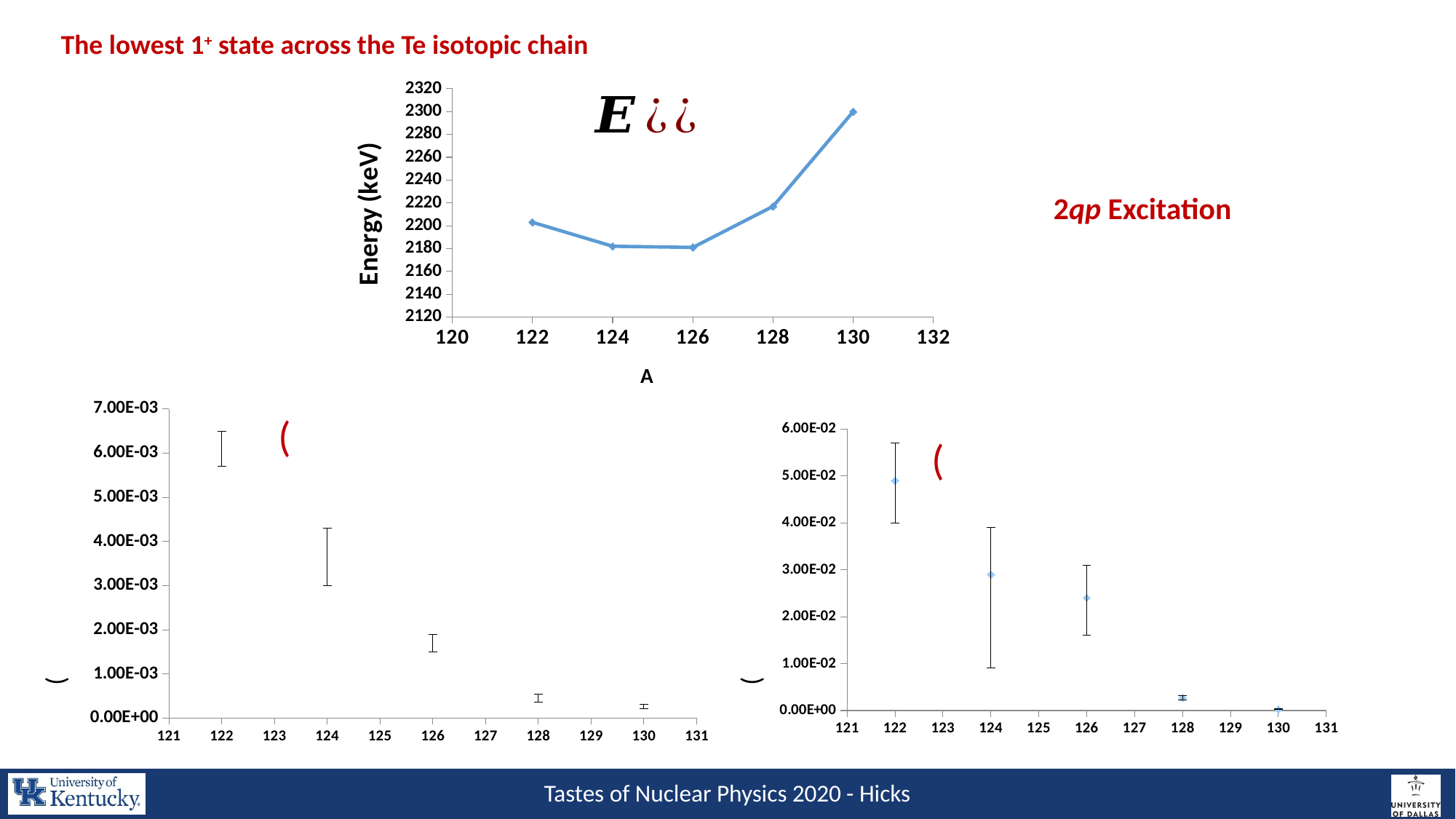
In the bottom-left chart, is the value at A = 122 greater or less than 5.00E-03? greater In the top chart (Energy vs A), is the energy at A = 130 greater or less than 2260? greater In the bottom-right chart, is the value at A = 124 greater or less than 4.00E-02? less In the bottom-left chart, do the values rise or fall as A increases from 122 to 130? fall In the top chart (Energy vs A), at which value of A is the energy highest? 130 In the bottom-left chart, at which value of A is the plotted value highest? 122 In the top chart (Energy vs A), what is the label of the vertical axis? Energy (keV) In the top chart (Energy vs A), which has the larger energy, A = 122 or A = 130? 130 In the top chart (Energy vs A), how many data points are plotted? 5 In the top chart (Energy vs A), what kind of chart is it? line chart In the bottom-right chart, how many data points are plotted? 5